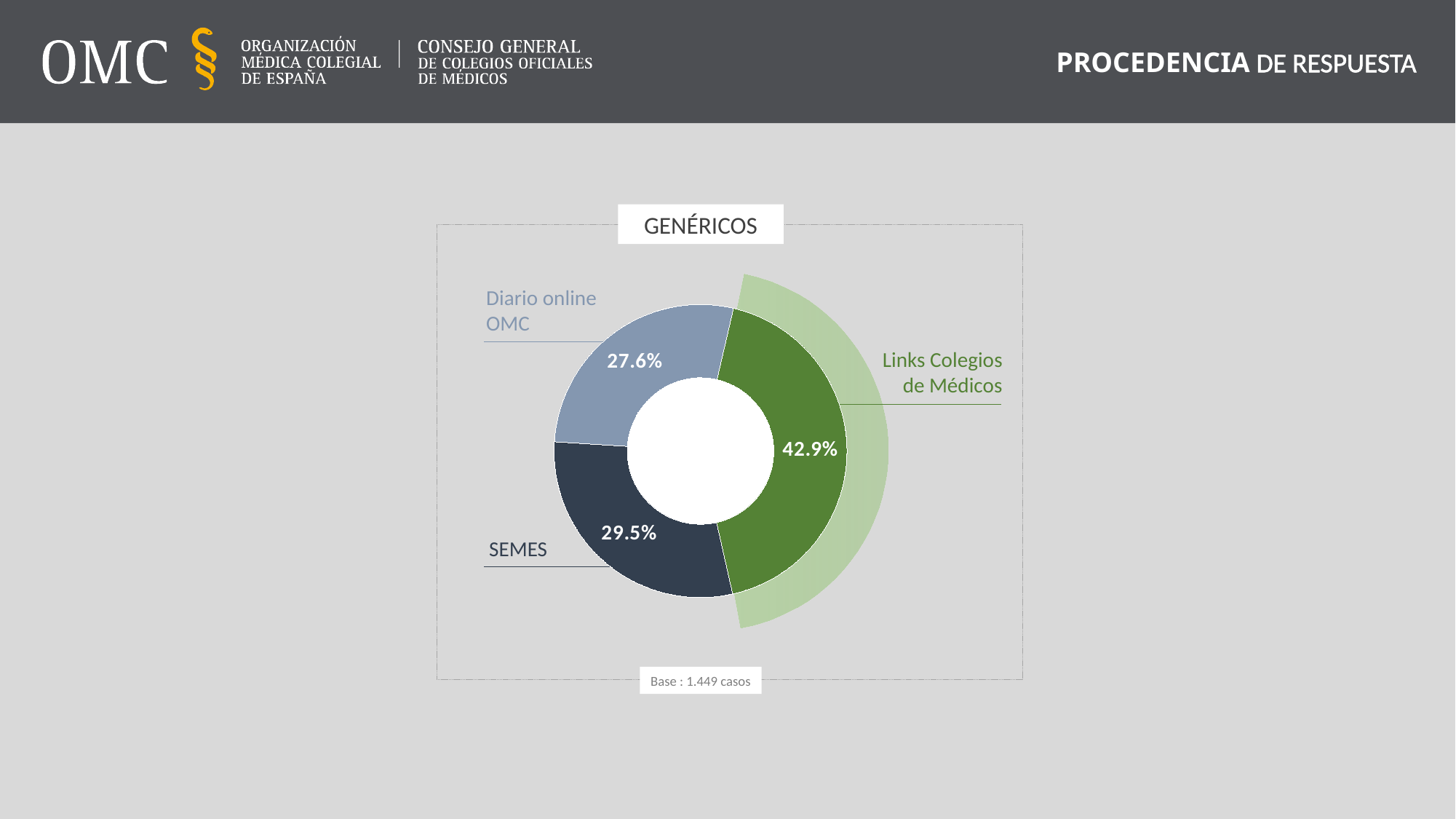
Which source accounts for the largest share of responses? Links Colegios de Médicos What percentage of responses came from Links Colegios de Médicos? 42.9% What is the difference in percentage points between SEMES and Diario online OMC? 1.9 How many sources of response are shown in the chart? 3 What base (number of cases) is stated below the chart? 1.449 casos Which source accounts for the smallest share of responses? Diario online OMC What percentage of responses came from Diario online OMC? 27.6% What is the title shown above the chart? GENÉRICOS What percentage of responses came from SEMES? 29.5% Which has a larger share, SEMES or Diario online OMC? SEMES What is the difference in percentage points between Links Colegios de Médicos and SEMES? 13.4 What kind of chart is shown on the slide? Doughnut (pie) chart